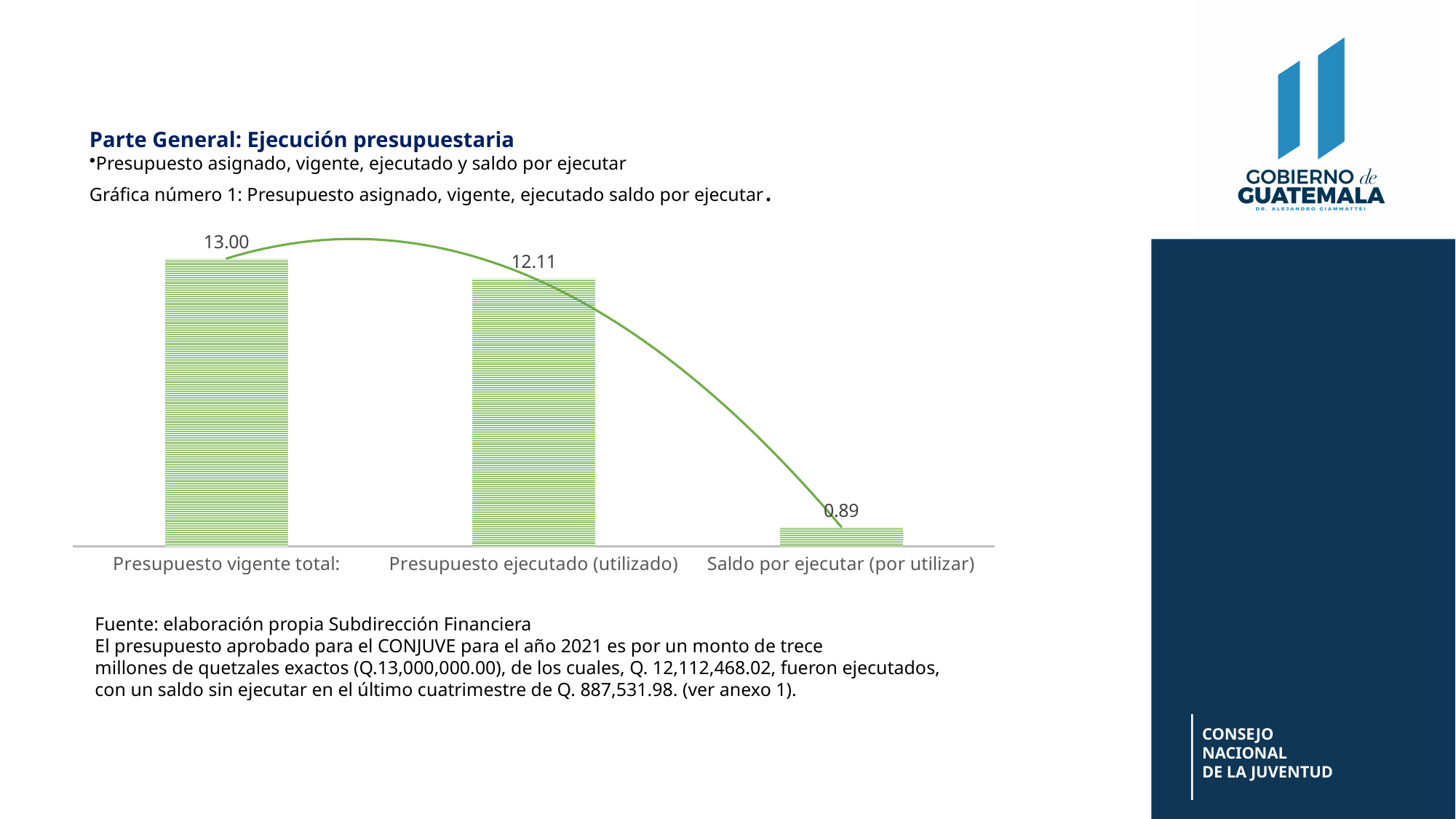
How many categories are shown in the chart? 3 Which is larger, Presupuesto ejecutado (utilizado) or Saldo por ejecutar (por utilizar)? Presupuesto ejecutado (utilizado) What is the difference between Presupuesto ejecutado (utilizado) and Saldo por ejecutar (por utilizar)? 11.22 Do the values rise or fall from left to right along the x axis? fall Which category has the highest value? Presupuesto vigente total: What is the value for Presupuesto ejecutado (utilizado)? 12.11 What is the title of the chart as given on the slide? Gráfica número 1: Presupuesto asignado, vigente, ejecutado saldo por ejecutar What is the value for Saldo por ejecutar (por utilizar)? 0.89 What is the difference between Presupuesto vigente total and Presupuesto ejecutado (utilizado)? 0.89 What kind of chart is this? bar chart What is the value for Presupuesto vigente total? 13.00 Which category has the lowest value? Saldo por ejecutar (por utilizar)